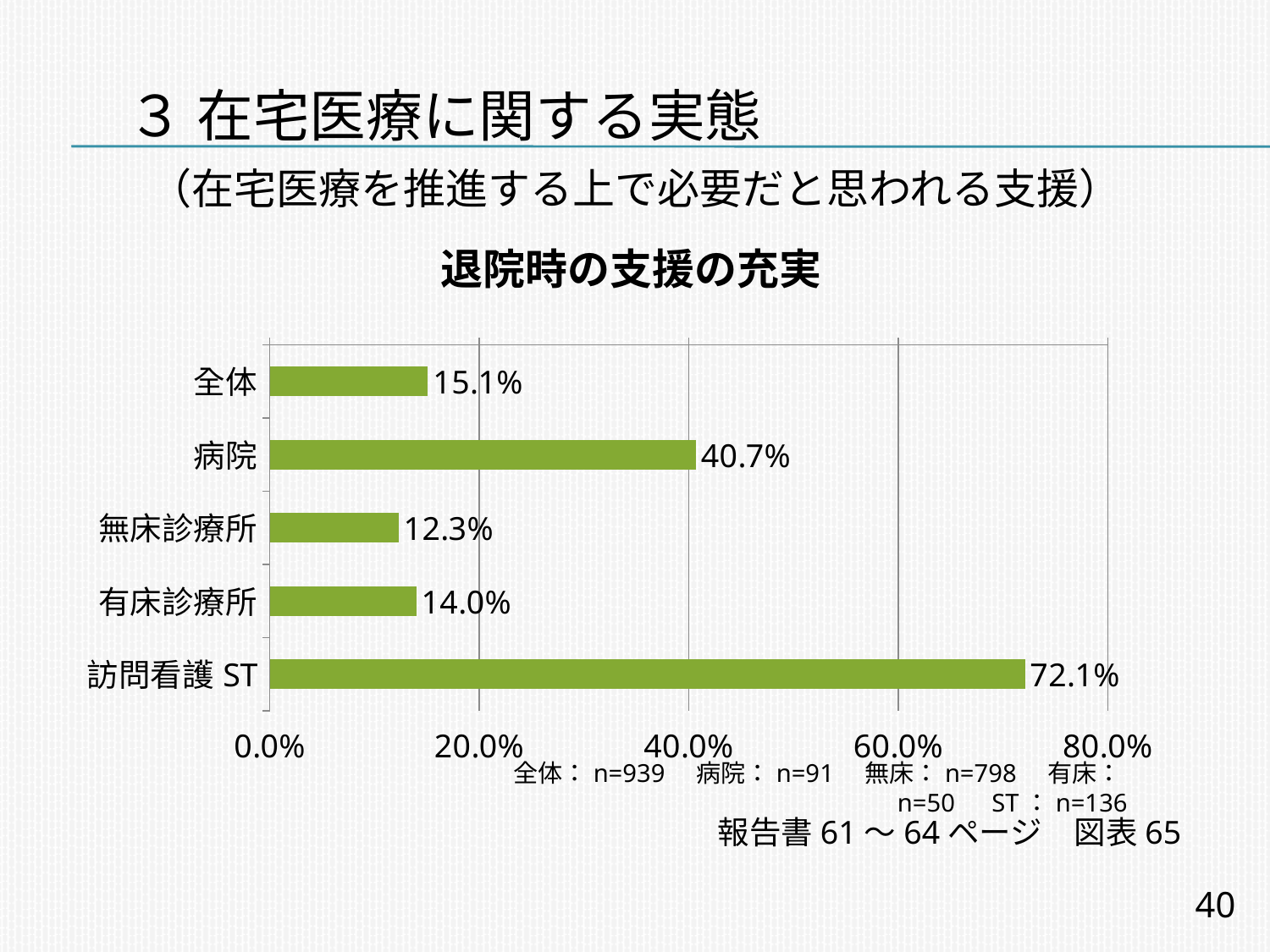
What is the difference between the values for 訪問看護ST and 病院? 31.4% What is the value for 無床診療所? 12.3% Which category has the lowest value? 無床診療所 Is the value for 病院 greater or less than 40.0%? greater What is the title of the chart? 退院時の支援の充実 Which category has the highest value? 訪問看護ST What is the value for 全体? 15.1% What is the value for 訪問看護ST? 72.1% What is the value for 病院? 40.7% How many categories are shown in the chart? 5 What kind of chart is shown on the slide? bar chart Which is larger, the value for 有床診療所 or the value for 無床診療所? 有床診療所